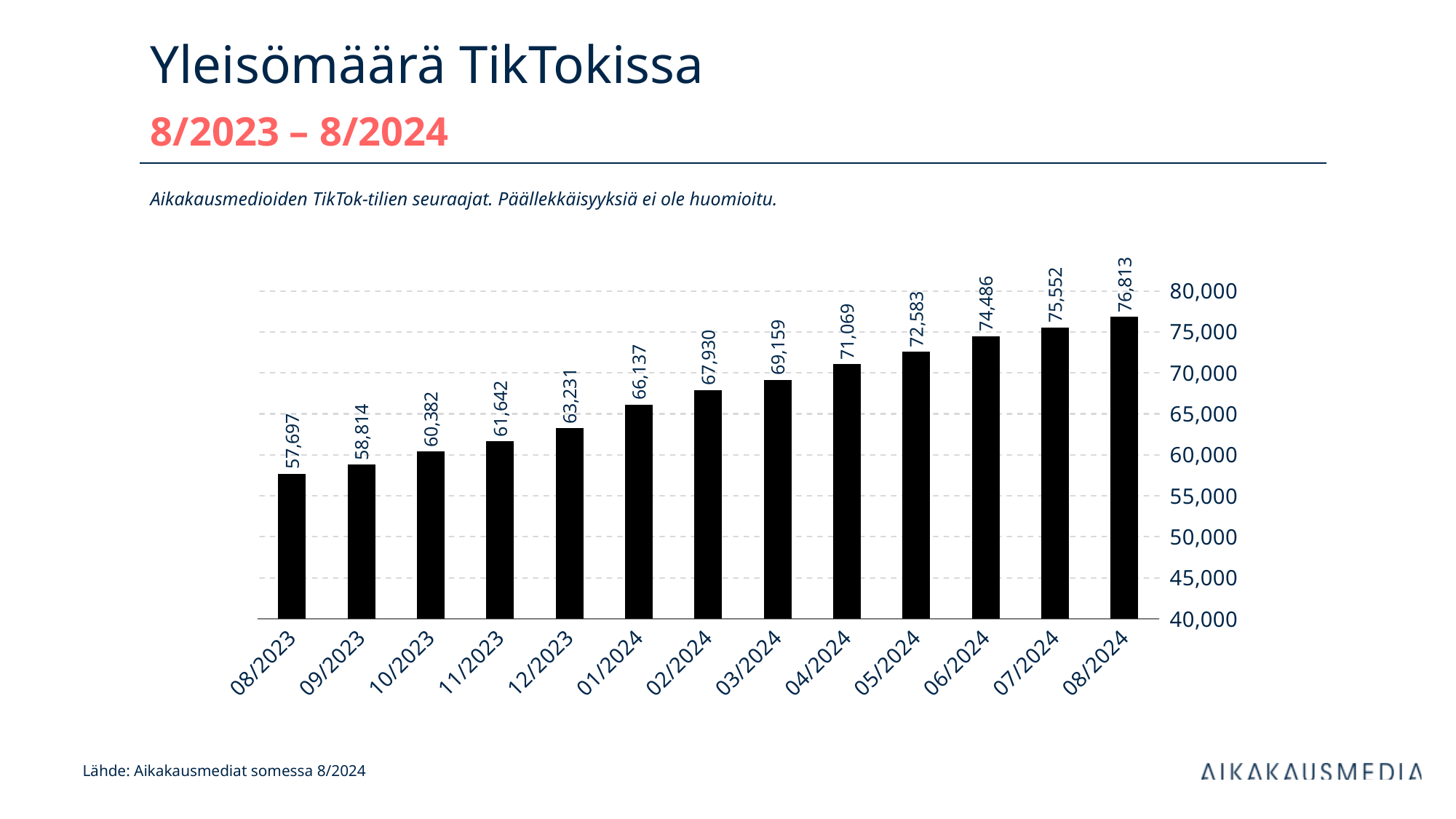
Which month has the lowest value? 08/2023 What kind of chart is shown on the slide? bar chart Which month has the highest value? 08/2024 What is the value for 08/2023? 57,697 Which is larger, the value for 03/2024 or the value for 05/2024? 05/2024 What is the value for 01/2024? 66,137 Do the values rise or fall from 08/2023 to 08/2024? rise What is the difference between the values for 12/2023 and 11/2023? 1,589 Is the value for 06/2024 greater or less than 70,000? greater What is the difference between the values for 08/2024 and 08/2023? 19,116 What is the value for 08/2024? 76,813 How many months are shown on the x axis? 13